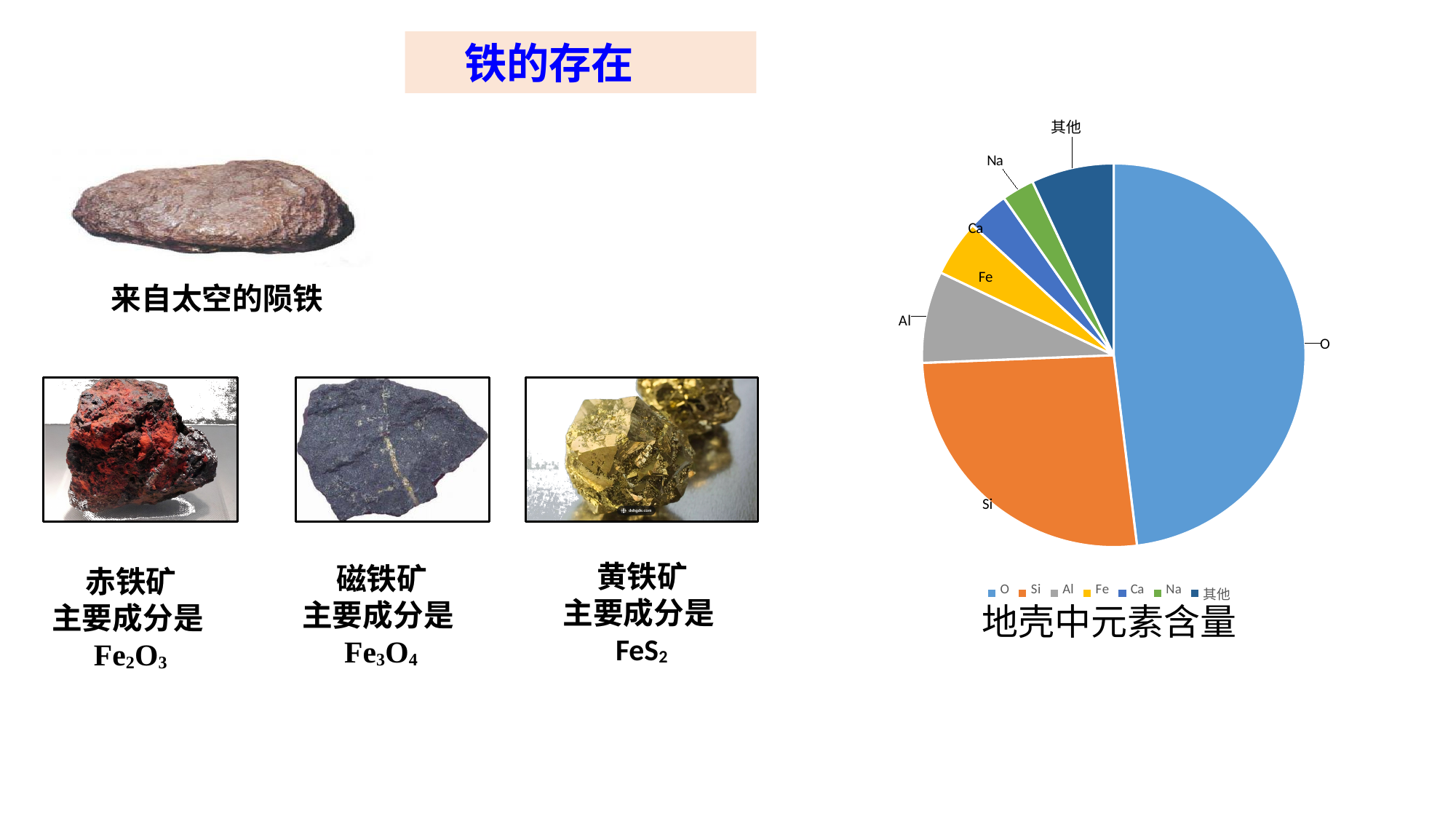
What colour is the Si slice in the pie chart? orange Which slice is larger in the pie chart, O or Si? O Which slice is larger in the pie chart, Al or Fe? Al What is the title of the pie chart? 地壳中元素含量 How many slices does the pie chart have? 7 Which slice is larger in the pie chart, 其他 or Na? 其他 Which element has the largest slice in the pie chart? O How many entries does the legend of the pie chart list? 7 What kind of chart is shown on the slide? pie chart